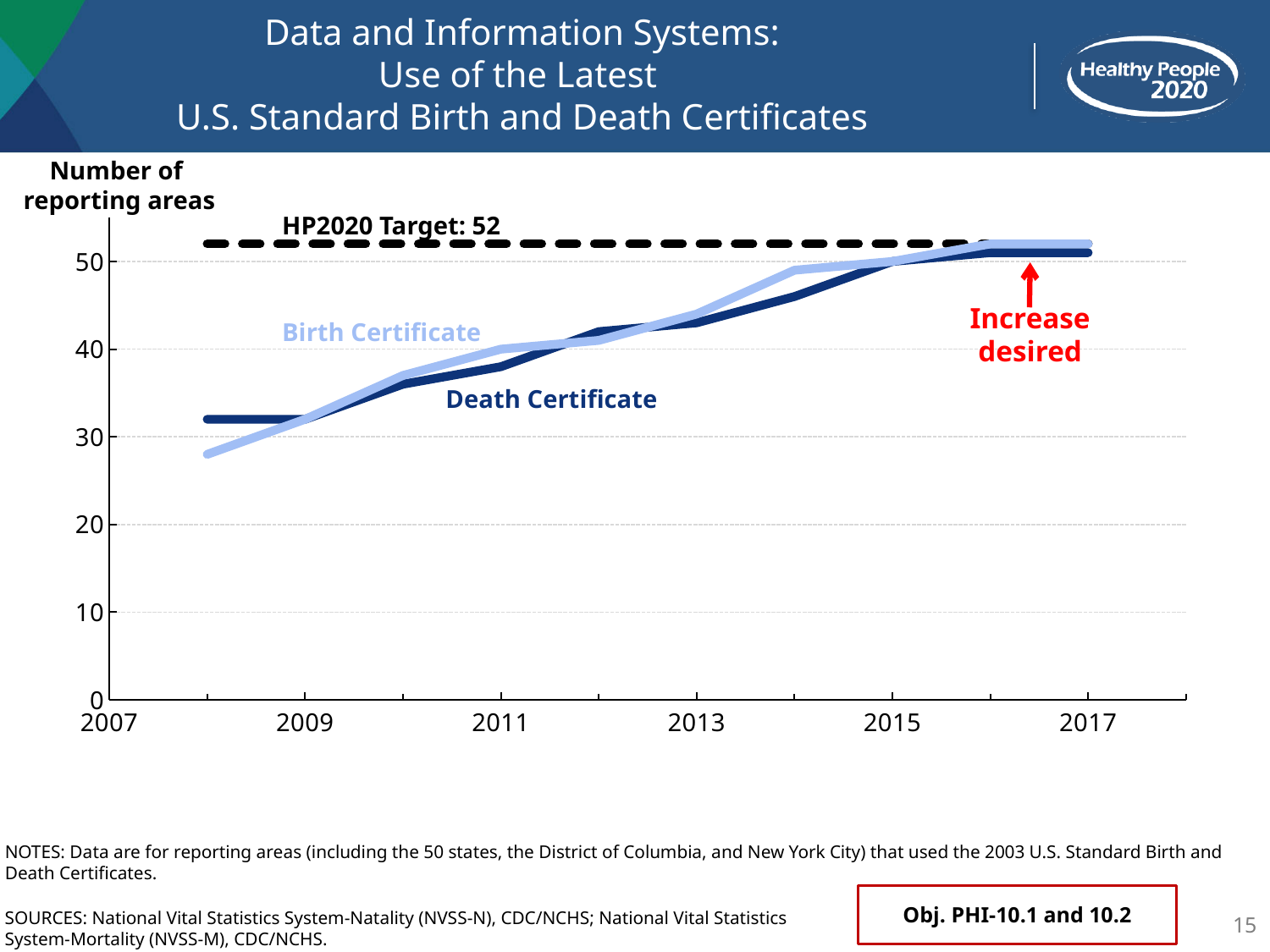
Which two series are plotted on the chart? Birth Certificate and Death Certificate How many certificate series are plotted on the chart? 2 Do the Death Certificate values rise or fall from 2008 to 2017? rise Is the value for Birth Certificate in 2008 greater or less than 30? less What kind of chart is shown on the slide? line chart Do the Birth Certificate values rise or fall from 2008 to 2017? rise Is the value for Birth Certificate in 2017 greater or less than 50? greater In 2014, which series has the higher value, Birth Certificate or Death Certificate? Birth Certificate Is the value for Death Certificate in 2008 greater or less than 30? greater In 2008, which series has the higher value, Birth Certificate or Death Certificate? Death Certificate What is the label of the vertical axis? Number of reporting areas What is the HP2020 Target value shown on the chart? 52